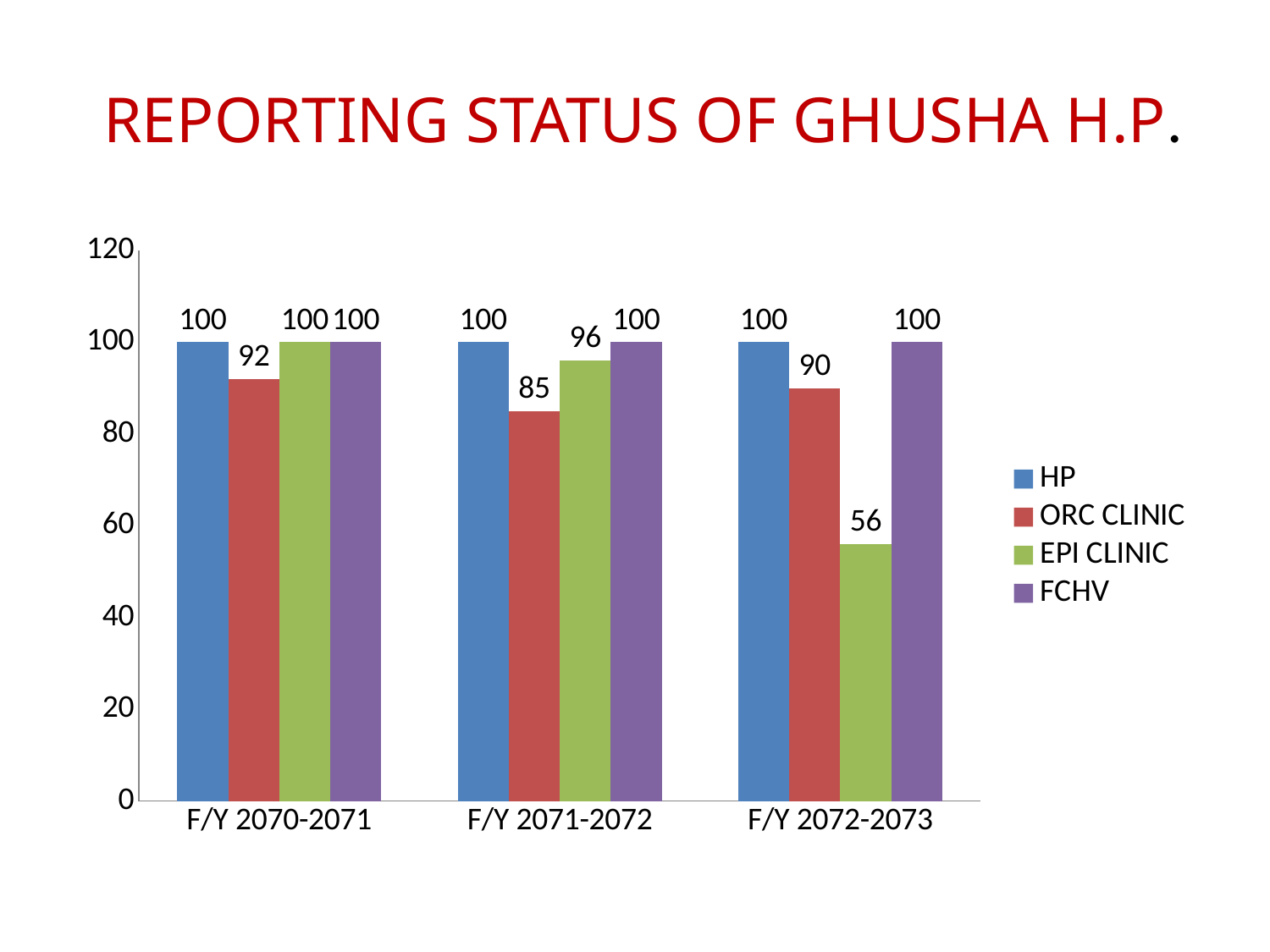
What is the value for EPI CLINIC in F/Y 2071-2072? 96 What is the value for EPI CLINIC in F/Y 2072-2073? 56 Which series has the lowest value in F/Y 2072-2073? EPI CLINIC What is the value for ORC CLINIC in F/Y 2070-2071? 92 Does the EPI CLINIC value rise or fall from F/Y 2071-2072 to F/Y 2072-2073? Fall How many series does the legend list? 4 What is the difference between the ORC CLINIC value in F/Y 2072-2073 and the ORC CLINIC value in F/Y 2071-2072? 5 What is the value for ORC CLINIC in F/Y 2071-2072? 85 What kind of chart is shown on the slide? Bar chart How many fiscal year categories are shown on the x axis? 3 Which series has the lowest value in F/Y 2071-2072? ORC CLINIC Which is larger: the EPI CLINIC value in F/Y 2071-2072 or the ORC CLINIC value in F/Y 2071-2072? EPI CLINIC